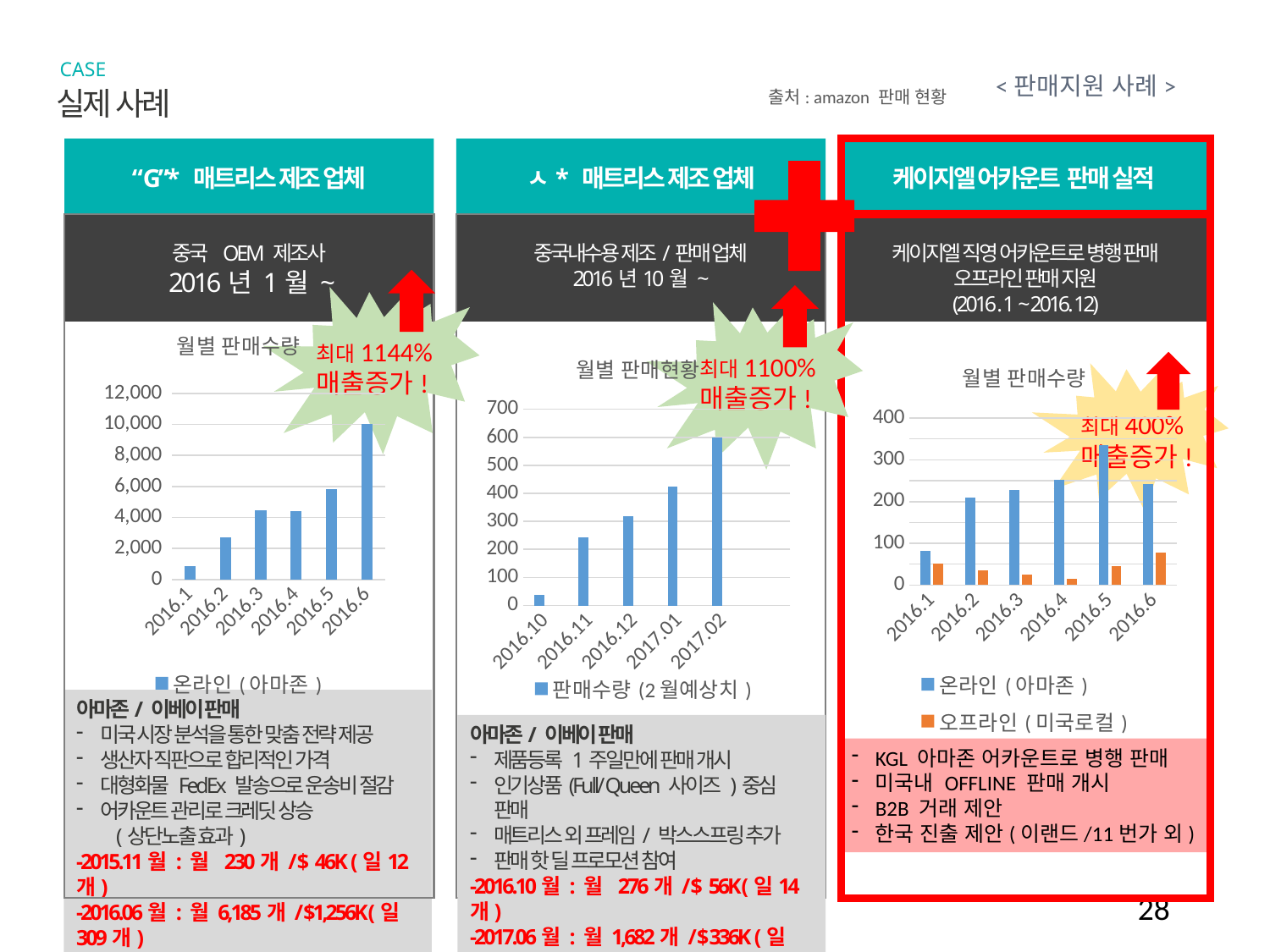
In the left chart (G* 매트리스 제조 업체), which month has the highest sales quantity? 2016.6 In the right chart (케이지엘 어카운트 판매 실적), is the 온라인 (아마존) value for 2016.5 greater or less than 300? greater In the left chart (G* 매트리스 제조 업체), how many months are plotted? 6 In the middle chart (ㅅ* 매트리스 제조 업체, 월별 판매현황), do the values rise or fall from 2016.10 to 2017.02? rise In the right chart (케이지엘 어카운트 판매 실적), which month has the highest 온라인 (아마존) value? 2016.5 What kind of chart is the left chart titled '월별 판매수량' under 'G* 매트리스 제조 업체'? bar chart In the middle chart (ㅅ* 매트리스 제조 업체, 월별 판매현황), is the value for 2016.10 greater or less than 100? less How many series does the legend of the right chart (케이지엘 어카운트 판매 실적) list? 2 How many charts are on the slide? 3 In the middle chart (ㅅ* 매트리스 제조 업체, 월별 판매현황), which month has the highest value? 2017.02 In the left chart (G* 매트리스 제조 업체), which month has the lowest sales quantity? 2016.1 In the left chart (G* 매트리스 제조 업체), is the value for 2016.6 greater or less than 8,000? greater